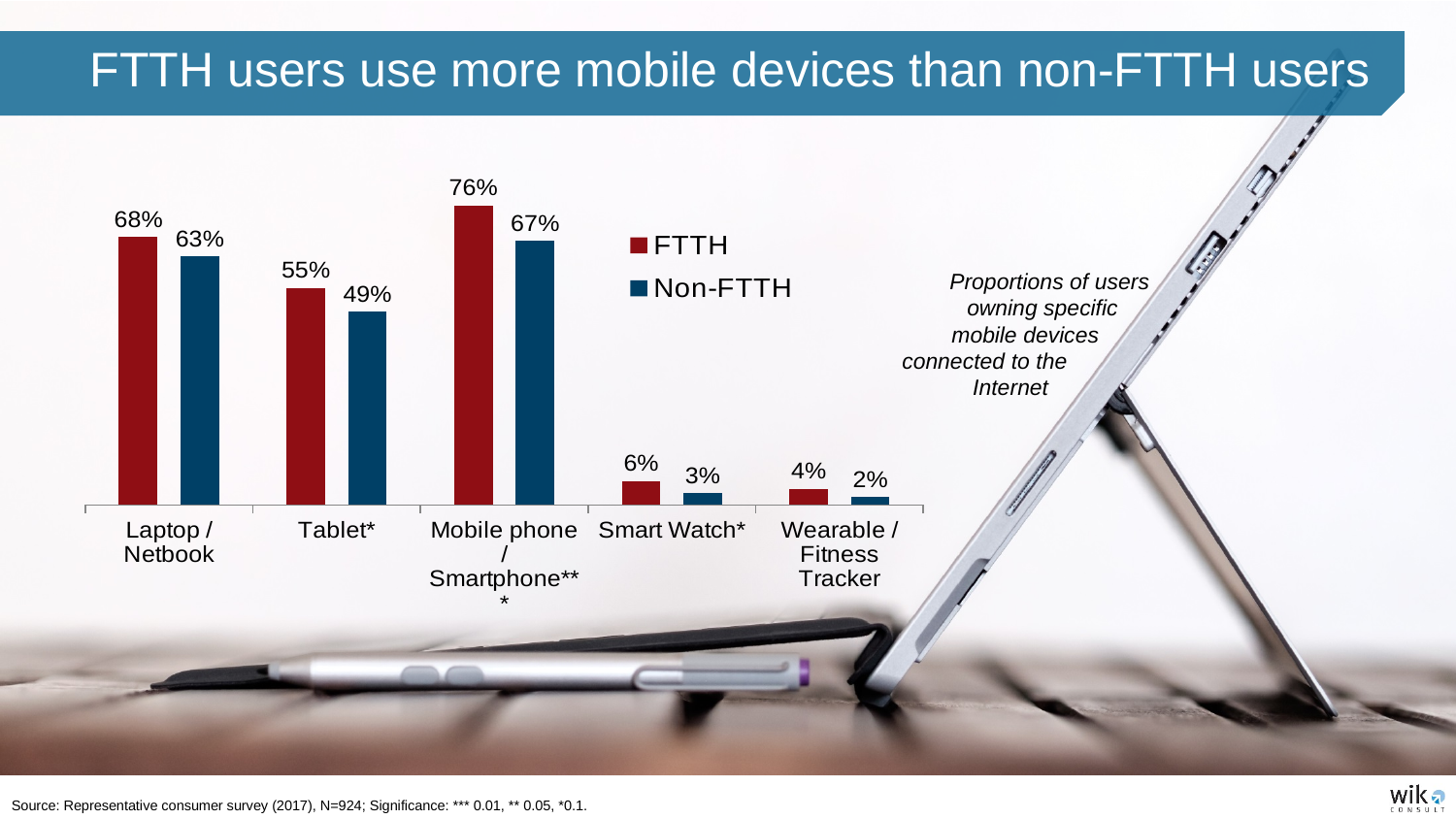
What percentage of Non-FTTH users own a Tablet? 49% What is the difference between FTTH and Non-FTTH users for Wearable / Fitness Tracker? 2 percentage points Which is larger: the FTTH value for Tablet or the Non-FTTH value for Laptop / Netbook? Non-FTTH value for Laptop / Netbook Which device category has the highest value for FTTH users? Mobile phone / Smartphone What is the difference between FTTH and Non-FTTH users for Mobile phone / Smartphone? 9 percentage points Which device category has the lowest value for Non-FTTH users? Wearable / Fitness Tracker How many series does the legend list? 2 Which colour represents the FTTH series in the legend? Red What is the value for Non-FTTH users for Smart Watch? 3% How many device categories are shown on the x axis? 5 What percentage of FTTH users own a Laptop / Netbook? 68% What kind of chart is shown on the slide? Bar chart